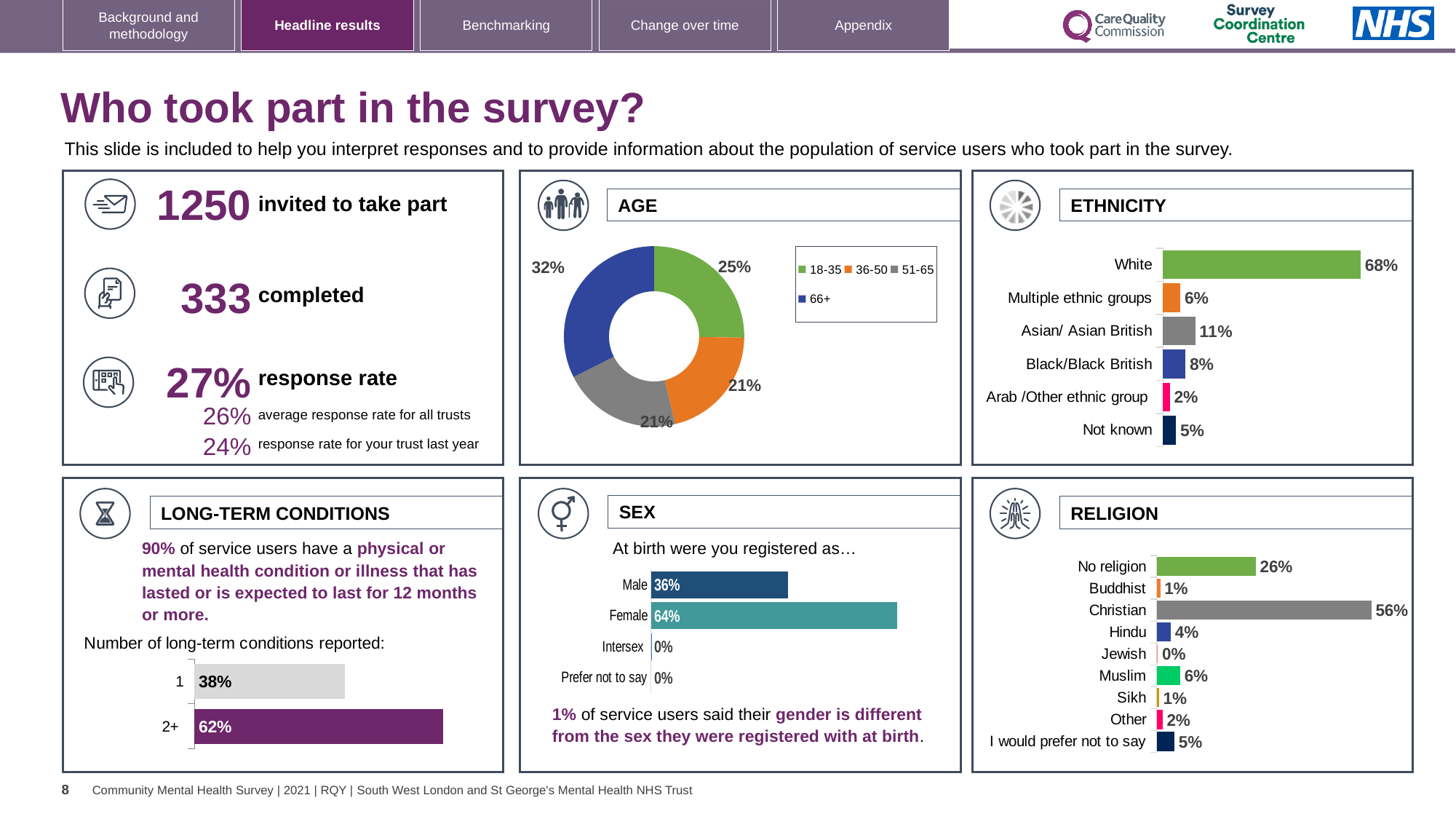
In the AGE chart, what share of respondents were aged 66+? 32% In the ETHNICITY chart, which category has the lowest value? Arab /Other ethnic group In the AGE chart, which age group has the largest share? 66+ How many age groups does the AGE chart legend list? 4 In the ETHNICITY chart, what is the difference between White and Black/Black British? 60% How many categories are shown in the RELIGION chart? 9 In the SEX chart, what is the difference between Female and Male? 28% In the LONG-TERM CONDITIONS chart, what percentage reported 2+ conditions? 62% In the SEX chart, which is larger, Male or Female? Female In the ETHNICITY chart, what is the value for Asian/ Asian British? 11% In the RELIGION chart, which religion category has the highest value? Christian What kind of chart is the AGE chart? Donut (pie) chart